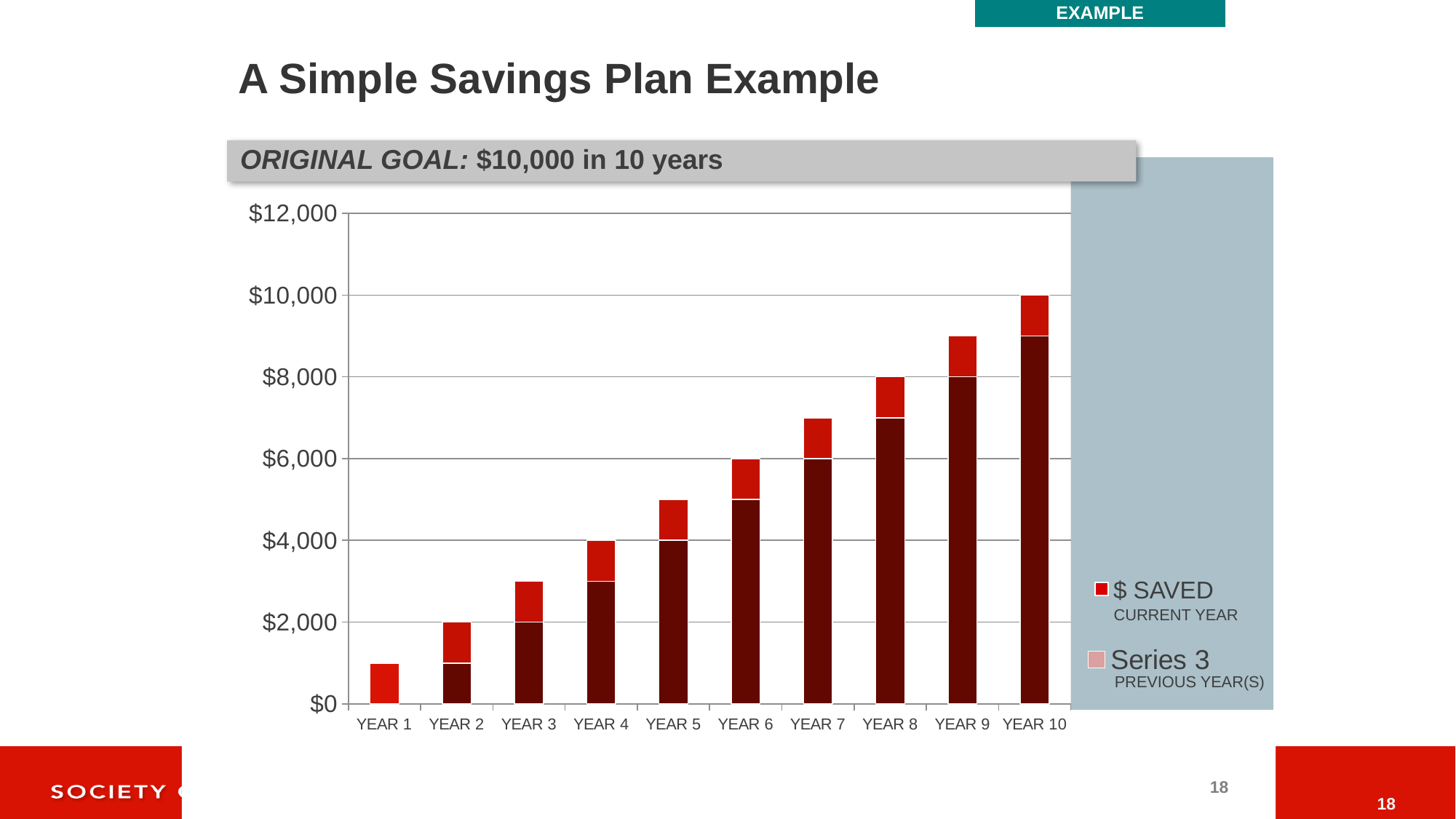
How many series does the chart's legend list? 2 Which year has the shortest stacked bar? YEAR 1 Is the total for YEAR 3 greater or less than $4,000? less What is the total height of the stacked bar for YEAR 4? $4,000 How many years (categories) are shown on the x axis of the chart? 10 Which has the larger total, YEAR 8 or YEAR 5? YEAR 8 Do the bar totals rise or fall from YEAR 1 to YEAR 10? rise What kind of chart is shown on the slide? bar chart What is the total height of the stacked bar for YEAR 10? $10,000 Which year has the tallest stacked bar? YEAR 10 What is the difference between the total for YEAR 10 and the total for YEAR 6? $4,000 Is the total for YEAR 7 greater or less than $6,000? greater